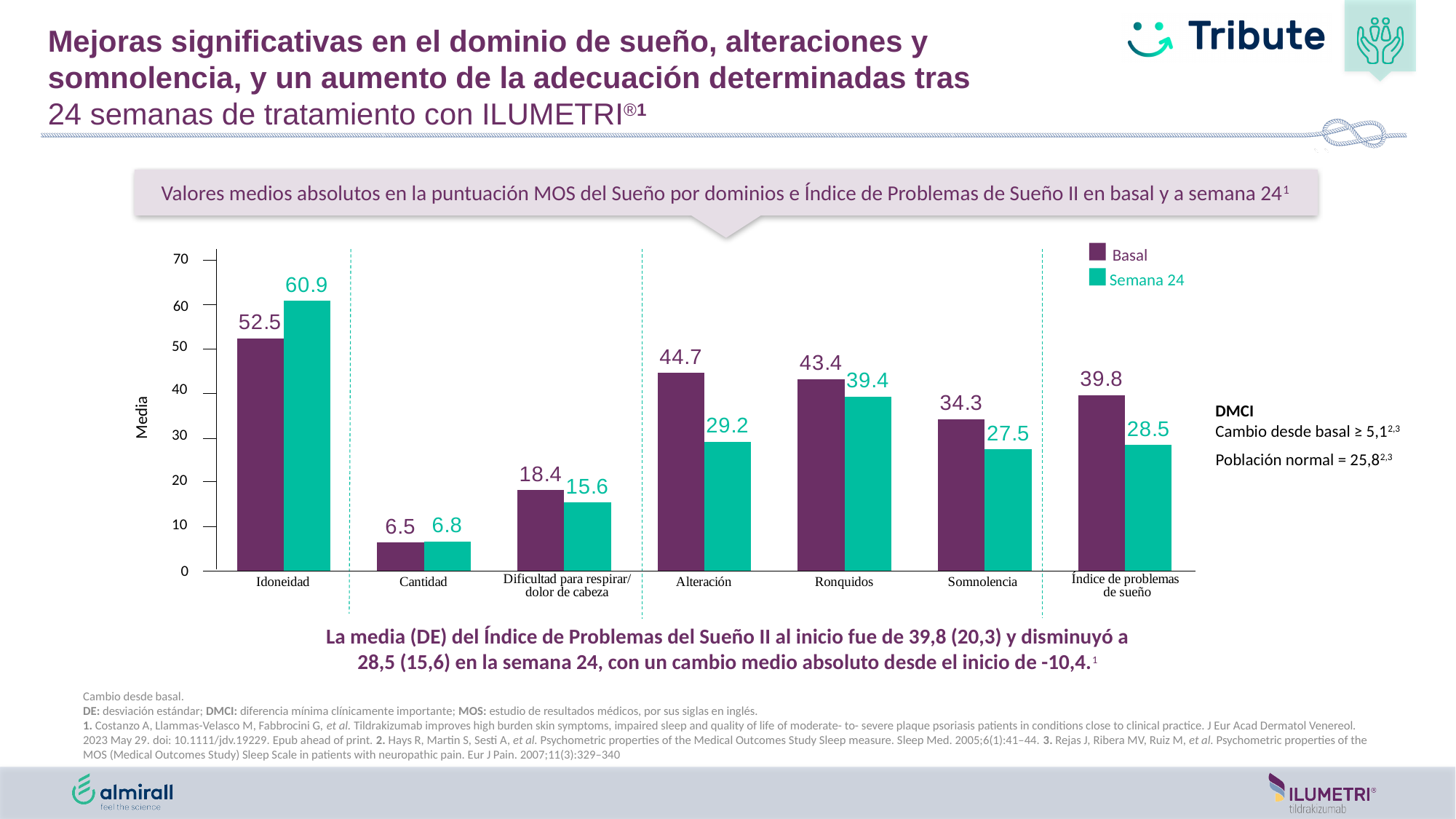
Which is larger for Ronquidos, the Basal value or the Semana 24 value? Basal What is the Semana 24 value for Alteración? 29.2 Which category has the highest Semana 24 value? Idoneidad What is the difference between the Basal and Semana 24 values for Alteración? 15.5 How many series does the legend list? 2 Which category has the lowest Basal value? Cantidad What is the Semana 24 value for Índice de problemas de sueño? 28.5 What is the label of the y axis? Media What kind of chart is shown on the slide? Bar chart What is the Basal value for Idoneidad? 52.5 What is the difference between the Basal and Semana 24 values for Índice de problemas de sueño? 11.3 How many categories are shown on the x axis? 7